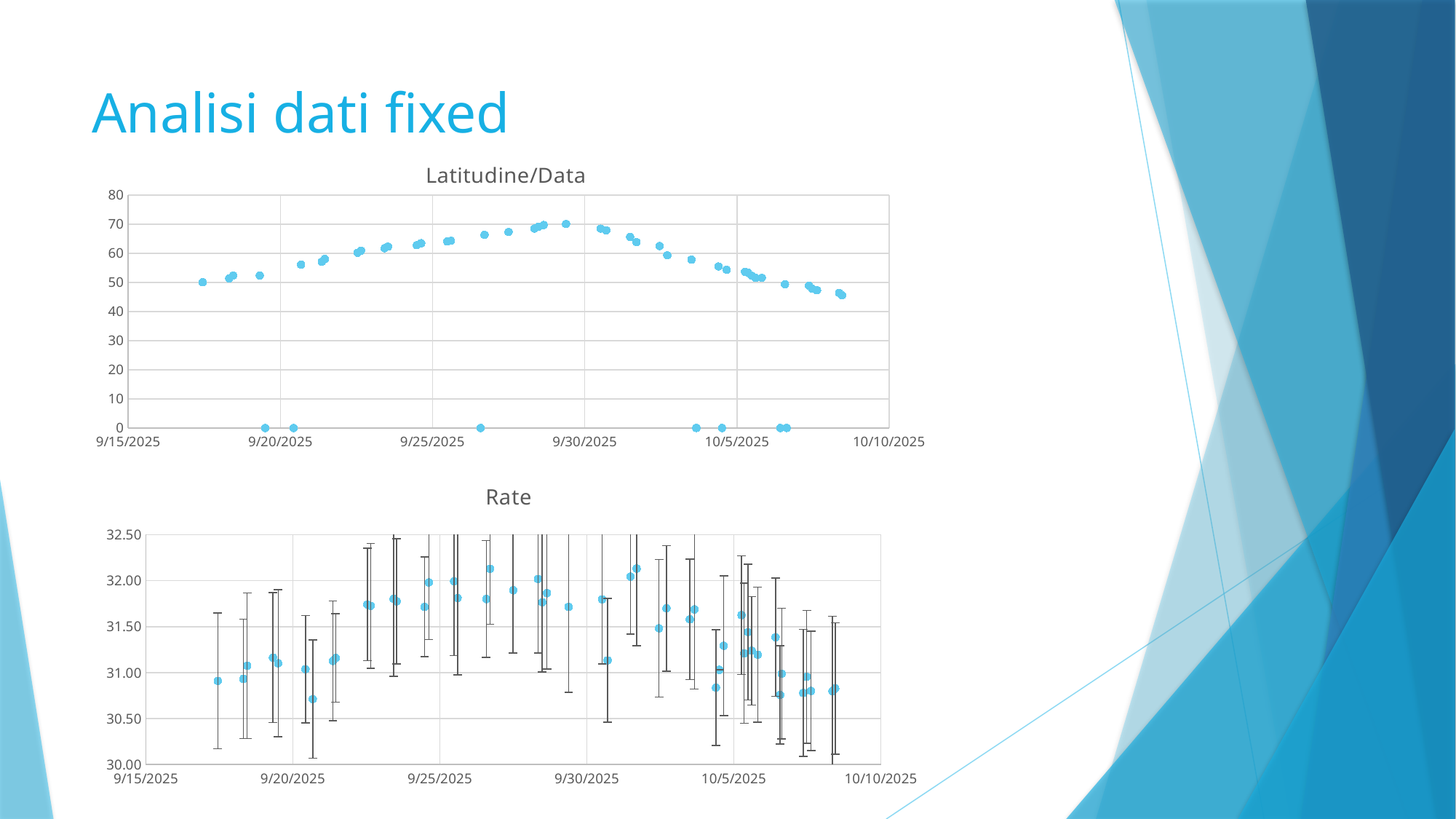
In the "Latitudine/Data" chart, do the non-zero values rise or fall between 9/30/2025 and 10/10/2025? fall In the "Rate" chart, is the first value plotted near 9/18/2025 greater or less than 31.50? less How many charts are shown on the slide? 2 What is the title of the top chart on the slide? Latitudine/Data In the "Rate" chart, what is the maximum value shown on the vertical axis? 32.50 In the "Latitudine/Data" chart, is the highest plotted value around 9/30/2025 greater or less than 60? greater What kind of chart is the "Rate" chart? scatter chart What is the title of the bottom chart on the slide? Rate In the "Latitudine/Data" chart, do the non-zero values rise or fall between 9/20/2025 and 9/30/2025? rise What kind of chart is the "Latitudine/Data" chart? scatter chart In the "Rate" chart, is the value plotted around 9/25/2025 greater or less than 31.50? greater